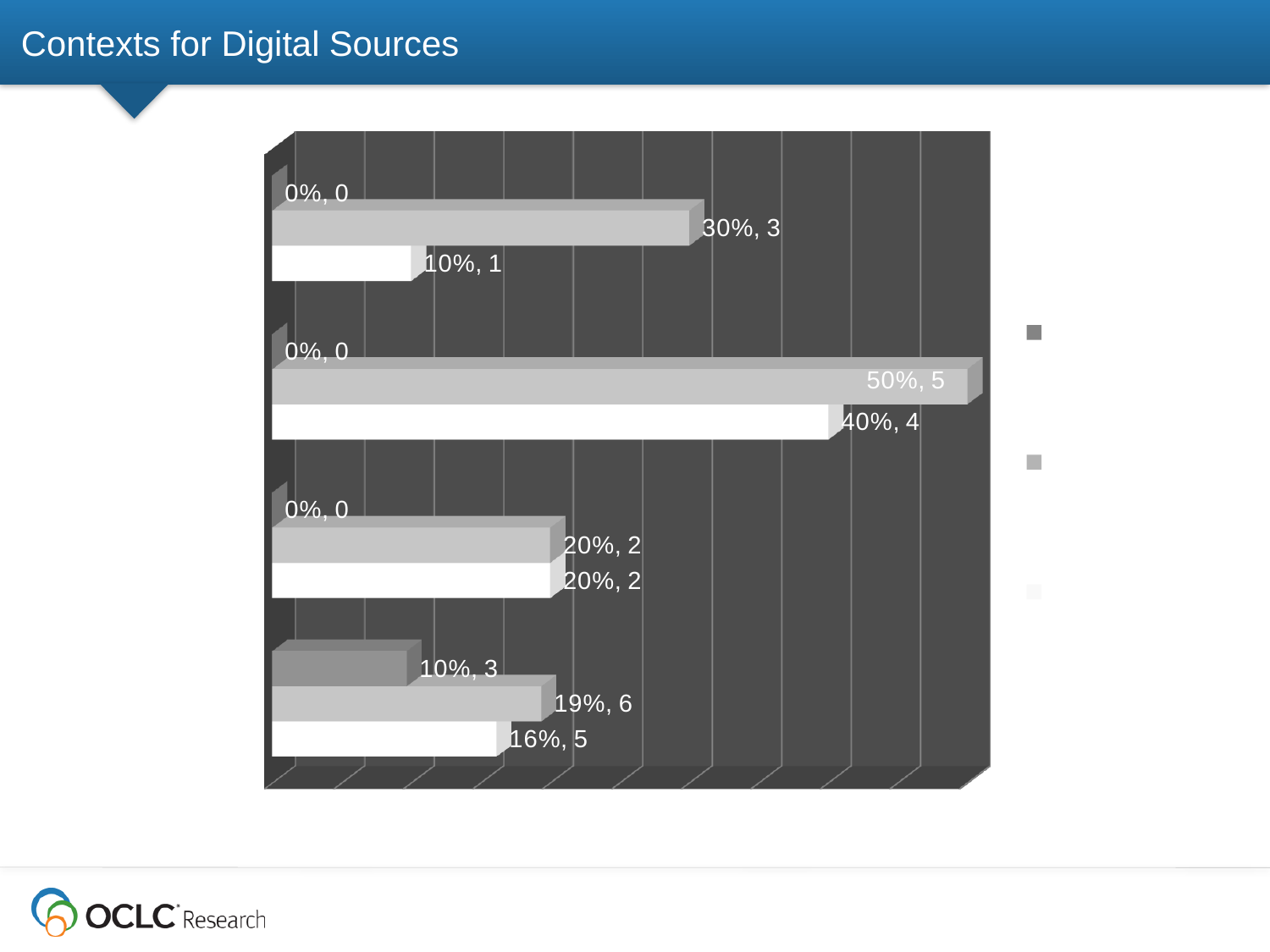
How many series does the legend list? 3 How many bars in the chart are labelled 0%? 3 What is the data label on the white bar in the top group? 10%, 1 How many groups of bars does the chart contain? 4 In the second group from the top, what is the difference in percentage between the light grey bar and the white bar? 10% What is the data label on the light grey bar in the second group from the top? 50%, 5 What kind of chart is shown on the slide? bar chart Which bar has the highest percentage in the chart? the light grey bar in the second group from the top (50%) What is the data label on the dark grey bar in the bottom group? 10%, 3 What is the data label on the white bar in the bottom group? 16%, 5 In the bottom group, which is larger: the light grey bar or the white bar? the light grey bar What is the title of the slide containing the chart? Contexts for Digital Sources